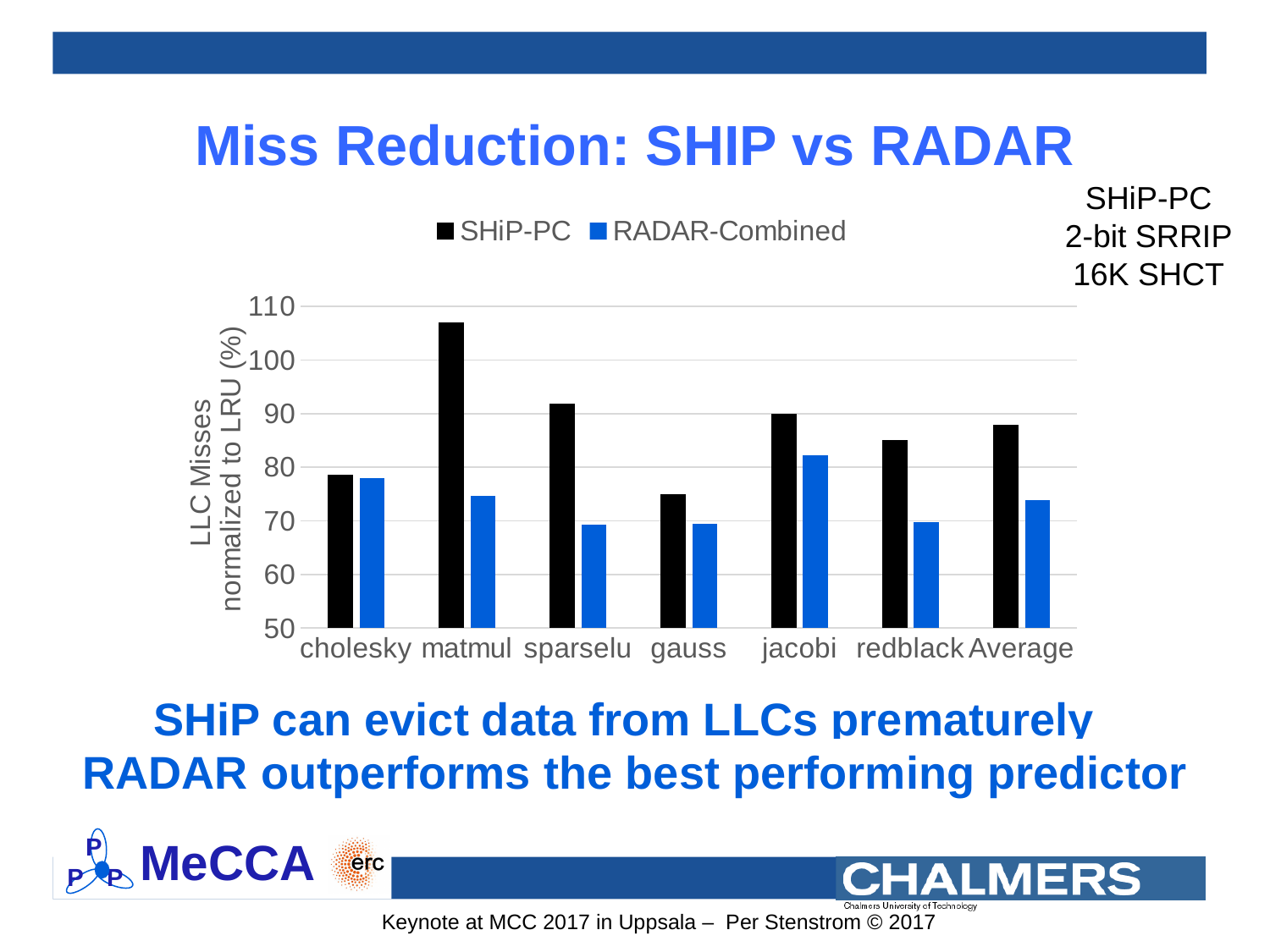
What is the title of the chart on the slide? Miss Reduction: SHIP vs RADAR Is the SHiP-PC value for matmul greater or less than 100? greater Is the RADAR-Combined value for jacobi greater or less than 80? greater Which category has the lowest SHiP-PC value? gauss Is the RADAR-Combined value for Average greater or less than 80? less Which category has the highest RADAR-Combined value? jacobi How many series does the legend list? 2 For matmul, which is larger: SHiP-PC or RADAR-Combined? SHiP-PC How many categories are shown on the x axis? 7 Which category has the highest SHiP-PC value? matmul What kind of chart is shown on the slide? bar chart